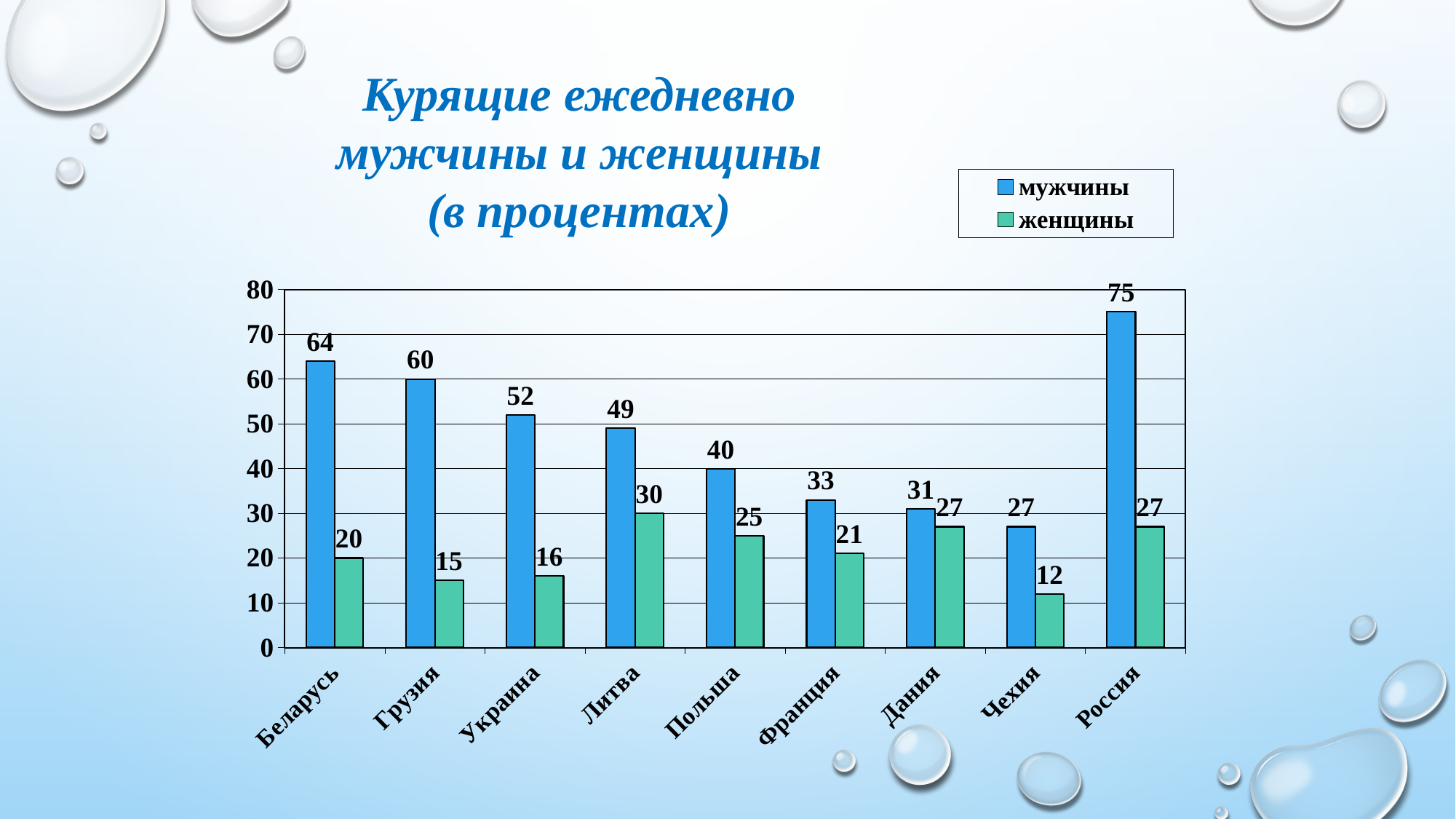
What is the value for женщины in Литва? 30 Which country has the highest value for мужчины? Россия What is the difference between the мужчины values for Россия and Чехия? 48 How many series does the legend list? 2 How many countries are shown on the x axis? 9 What is the value for мужчины in Польша? 40 Which series is shown in blue according to the legend? мужчины What is the value for мужчины in Россия? 75 What is the difference between the мужчины and женщины values for Беларусь? 44 Which is larger: the женщины value for Грузия or the женщины value for Украина? Украина Which country has the lowest value for женщины? Чехия What kind of chart is shown on the slide? Bar chart